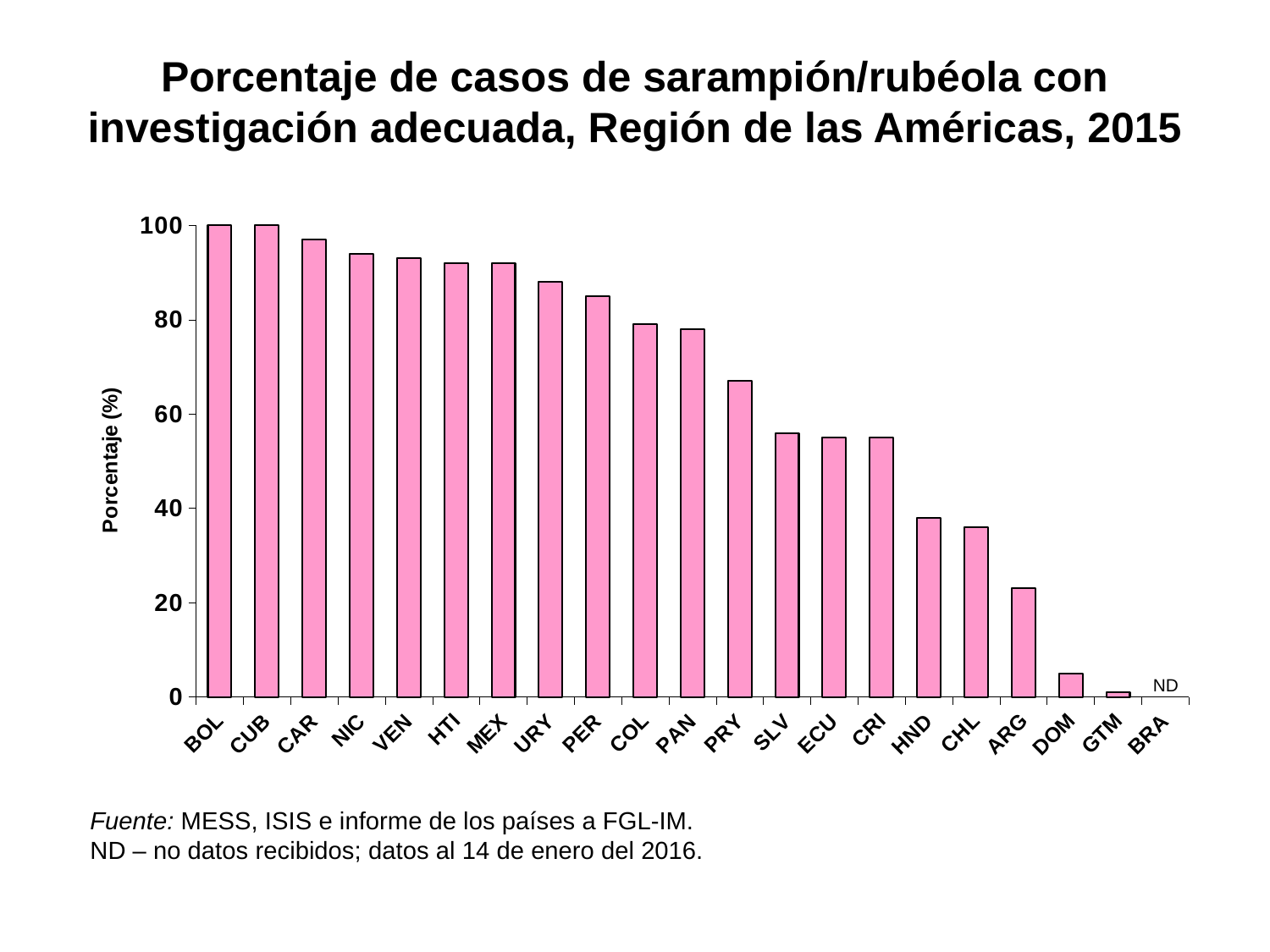
Is the value for NIC greater or less than 80? greater What is the value for BOL? 100 What kind of chart is shown on the slide? bar chart Which has the larger value, PRY or SLV? PRY Do the values generally rise or fall from left to right along the x axis? fall What is the value for CUB? 100 How many countries are listed along the x axis of the chart? 21 Which has the larger value, HND or ARG? HND Is the value for ARG greater or less than 40? less Is the value for SLV greater or less than 40? greater Among the countries with a bar shown, which has the lowest value? GTM Which country is marked ND (no data received) on the chart? BRA